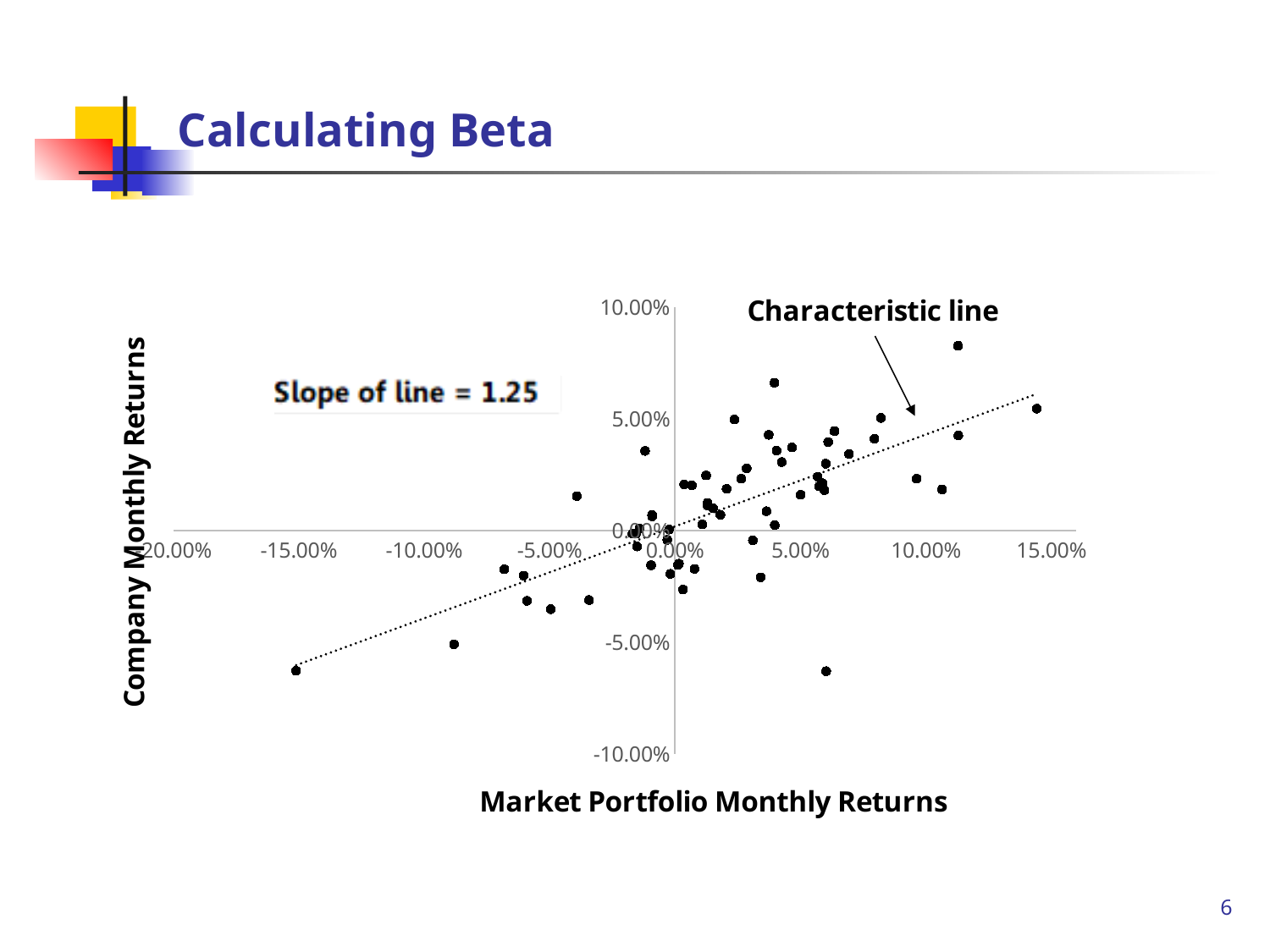
Is the company monthly return for the lowest point on the chart greater or less than -5.00%? less Is the company monthly return for the leftmost point (near -15.00% market return) greater or less than -5.00%? less What is the title of the x axis of the chart? Market Portfolio Monthly Returns Is the company monthly return for the highest point on the chart greater or less than 5.00%? greater What is the slope of the characteristic line stated on the slide? 1.25 What kind of chart is shown on the slide? scatter chart Do the company monthly returns generally rise or fall as market portfolio monthly returns increase along the x axis? rise